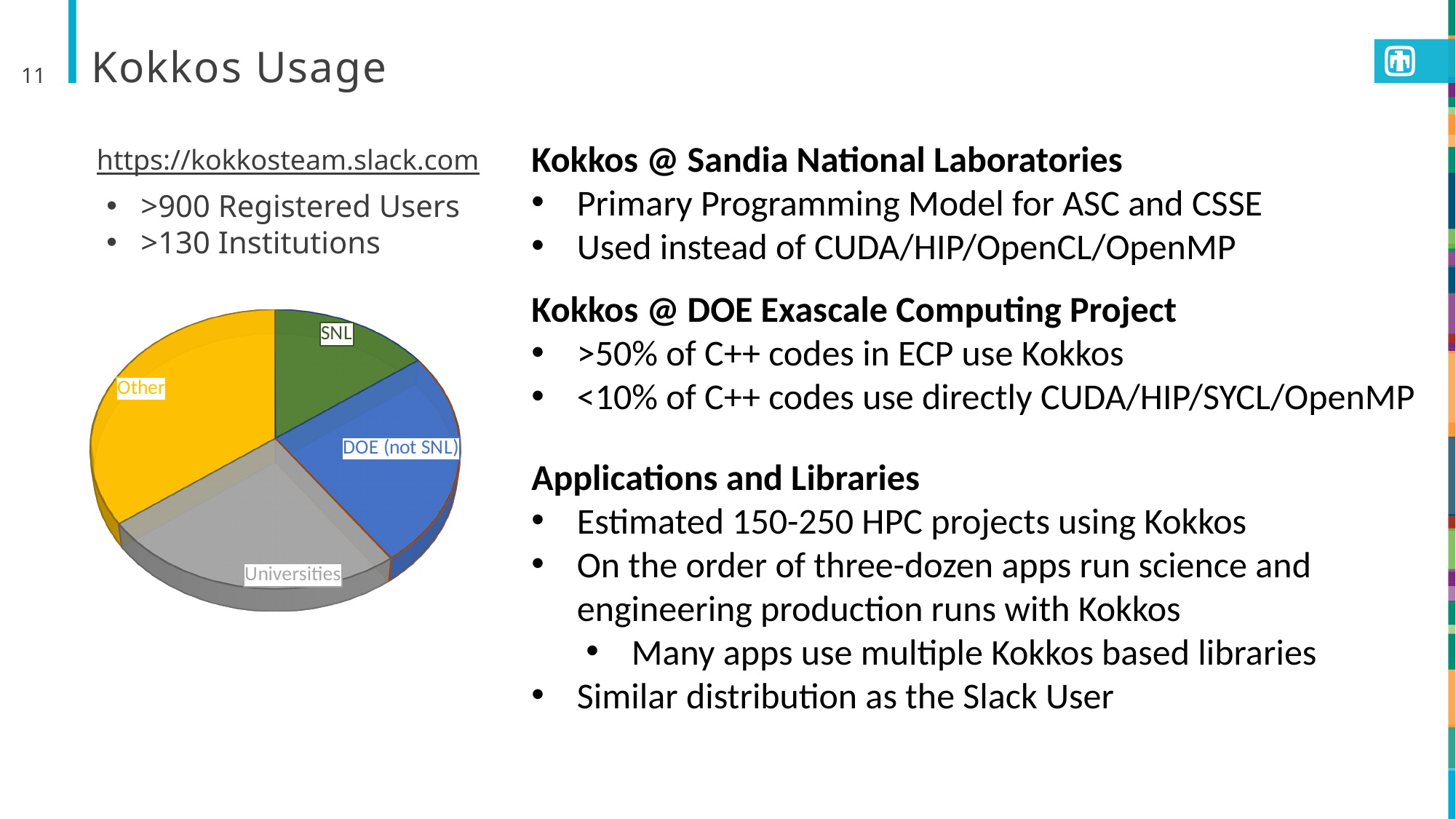
Which slice of the pie chart is coloured yellow? Other Which is larger in the pie chart, the DOE (not SNL) slice or the Other slice? Other What colour is the SNL slice in the pie chart? green What kind of chart is shown on the slide? pie chart Which slice of the pie chart is the smallest? SNL Which is larger in the pie chart, the SNL slice or the Universities slice? Universities How many slices does the pie chart have? 4 Which is larger in the pie chart, the SNL slice or the DOE (not SNL) slice? DOE (not SNL)